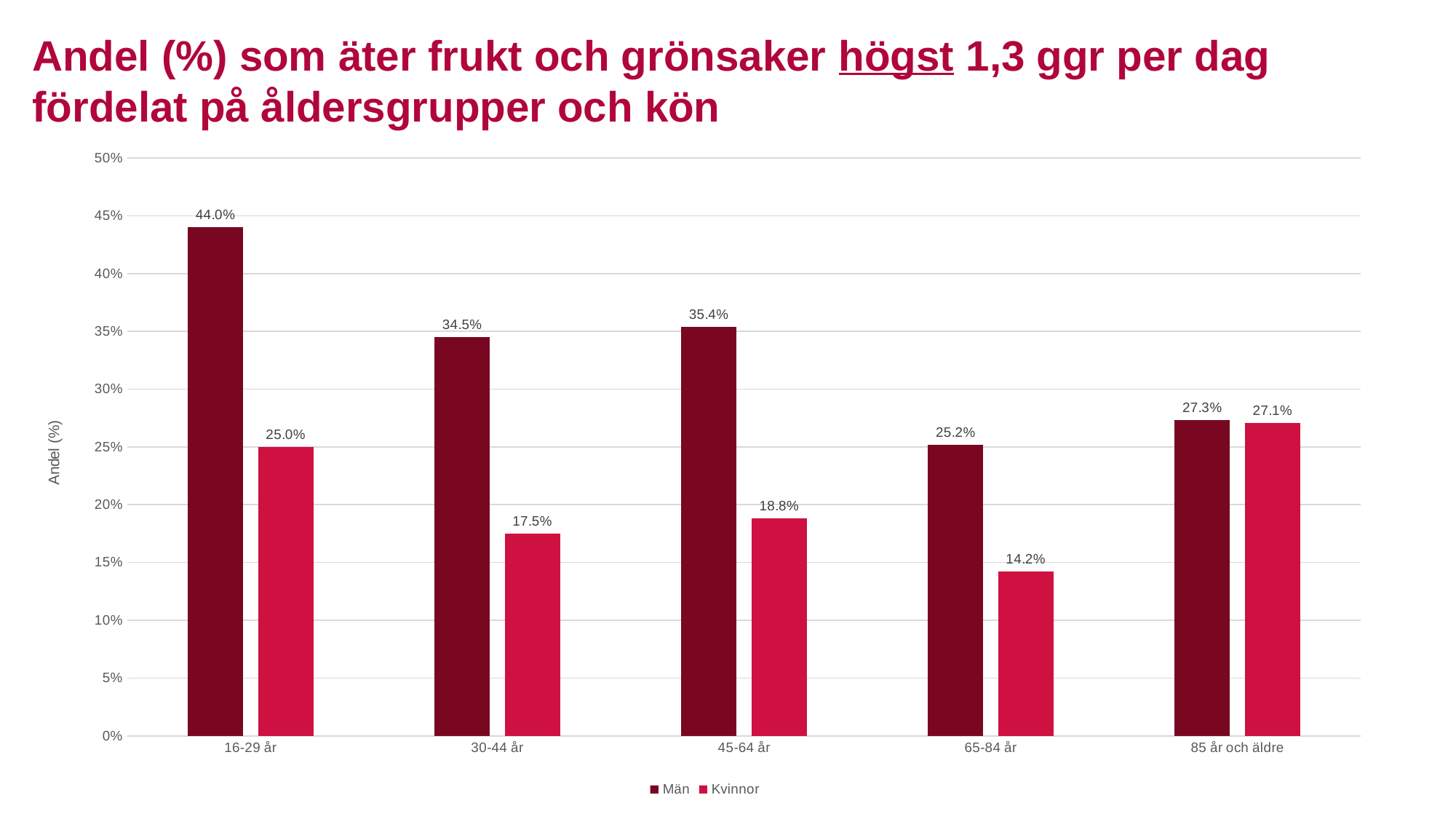
What kind of chart is shown on the slide? Bar chart What is the difference between Män and Kvinnor in the 30-44 år age group? 17.0% What is the value for Kvinnor in the 65-84 år age group? 14.2% How many series does the legend list? 2 What is the label of the y axis? Andel (%) What is the value for Män in the 16-29 år age group? 44.0% What is the difference between Män and Kvinnor in the 16-29 år age group? 19.0% How many age groups are shown on the x axis? 5 What is the value for Kvinnor in the 45-64 år age group? 18.8% Which age group has the lowest value for Kvinnor? 65-84 år Which age group has the highest value for Män? 16-29 år Which is larger, the value for Män in 45-64 år or the value for Män in 65-84 år? Män in 45-64 år